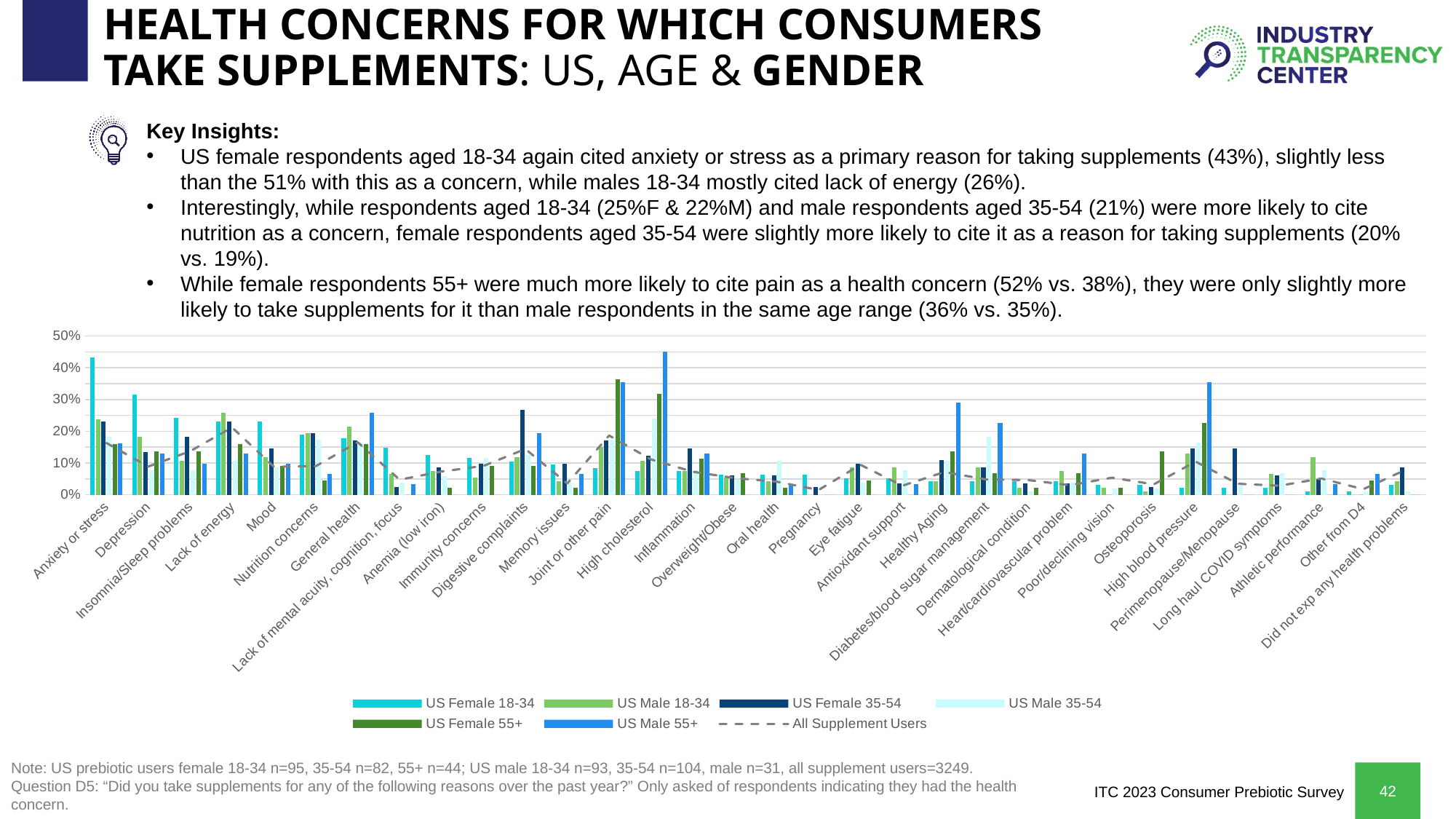
How many series does the chart legend list? 7 What kind of chart is shown on the slide? combination bar and line chart Is the US Male 55+ value for High blood pressure greater or less than 30%? greater For which category is the US Male 55+ bar the highest? High cholesterol How many health concern categories are shown along the x axis? 32 Is the US Female 35-54 value for Digestive complaints greater or less than 20%? greater Is the US Male 55+ value for High cholesterol greater or less than 40%? greater Which series has the highest bar for Anxiety or stress? US Female 18-34 Which series is represented by the dashed grey line in the chart? All Supplement Users For Anxiety or stress, which is larger: the US Female 18-34 value or the US Male 18-34 value? US Female 18-34